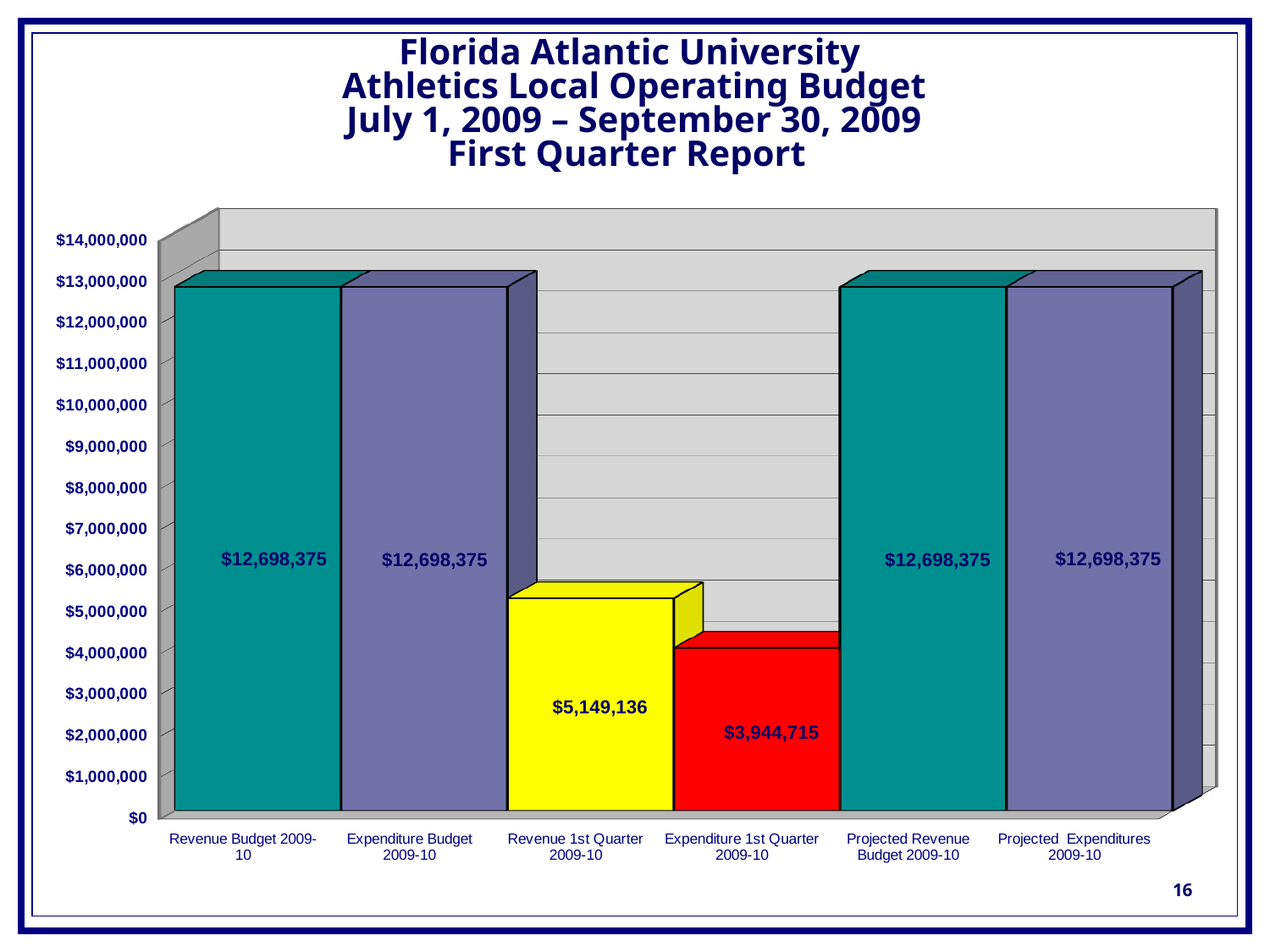
What is the difference between Revenue 1st Quarter 2009-10 and Expenditure 1st Quarter 2009-10? $1,204,421 How many categories are shown on the chart? 6 What kind of chart is shown on the slide? bar chart Is the value for Expenditure 1st Quarter 2009-10 greater or less than $4,000,000? less What colour is the bar for Revenue 1st Quarter 2009-10? yellow What is the value for Expenditure 1st Quarter 2009-10? $3,944,715 Which is larger, Revenue 1st Quarter 2009-10 or Expenditure 1st Quarter 2009-10? Revenue 1st Quarter 2009-10 What is the value for Revenue 1st Quarter 2009-10? $5,149,136 What is the value for Projected Expenditures 2009-10? $12,698,375 Which category has the lowest value? Expenditure 1st Quarter 2009-10 What is the difference between Revenue Budget 2009-10 and Revenue 1st Quarter 2009-10? $7,549,239 What is the value for Revenue Budget 2009-10? $12,698,375